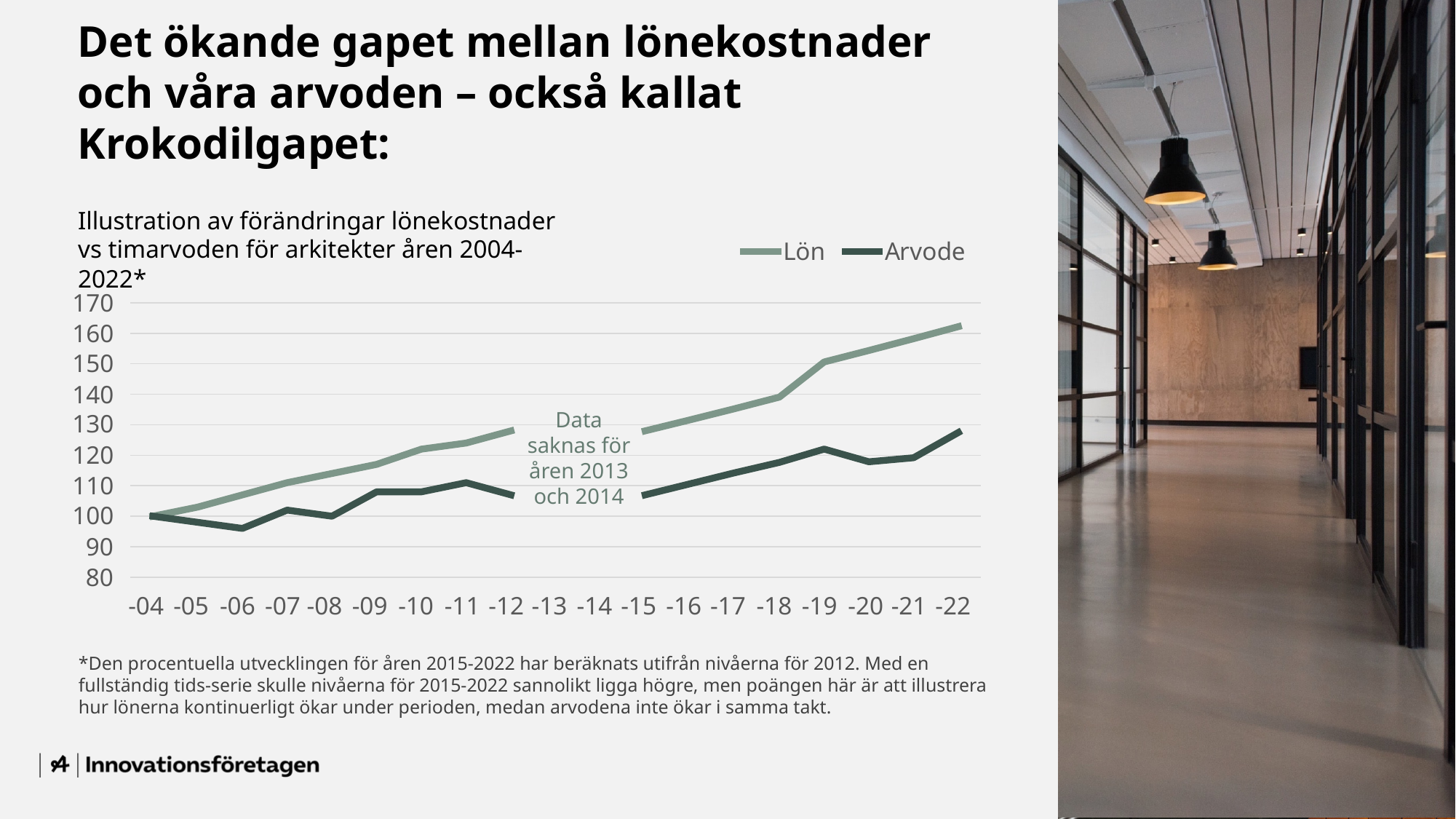
Is the value for Lön in -22 greater or less than 150? greater Is the value for Lön in -19 greater or less than 140? greater How many series does the chart legend list? 2 For which years does the chart note that data is missing? 2013 and 2014 What are the two series named in the chart legend? Lön and Arvode Is the value for Arvode in -06 greater or less than 100? less In -22, which series has the higher value, Lön or Arvode? Lön What is the value of Lön in -04? 100 What kind of chart is shown on the slide? line chart In which year does the Lön series reach its highest value? -22 How many year labels are shown on the x axis of the chart? 19